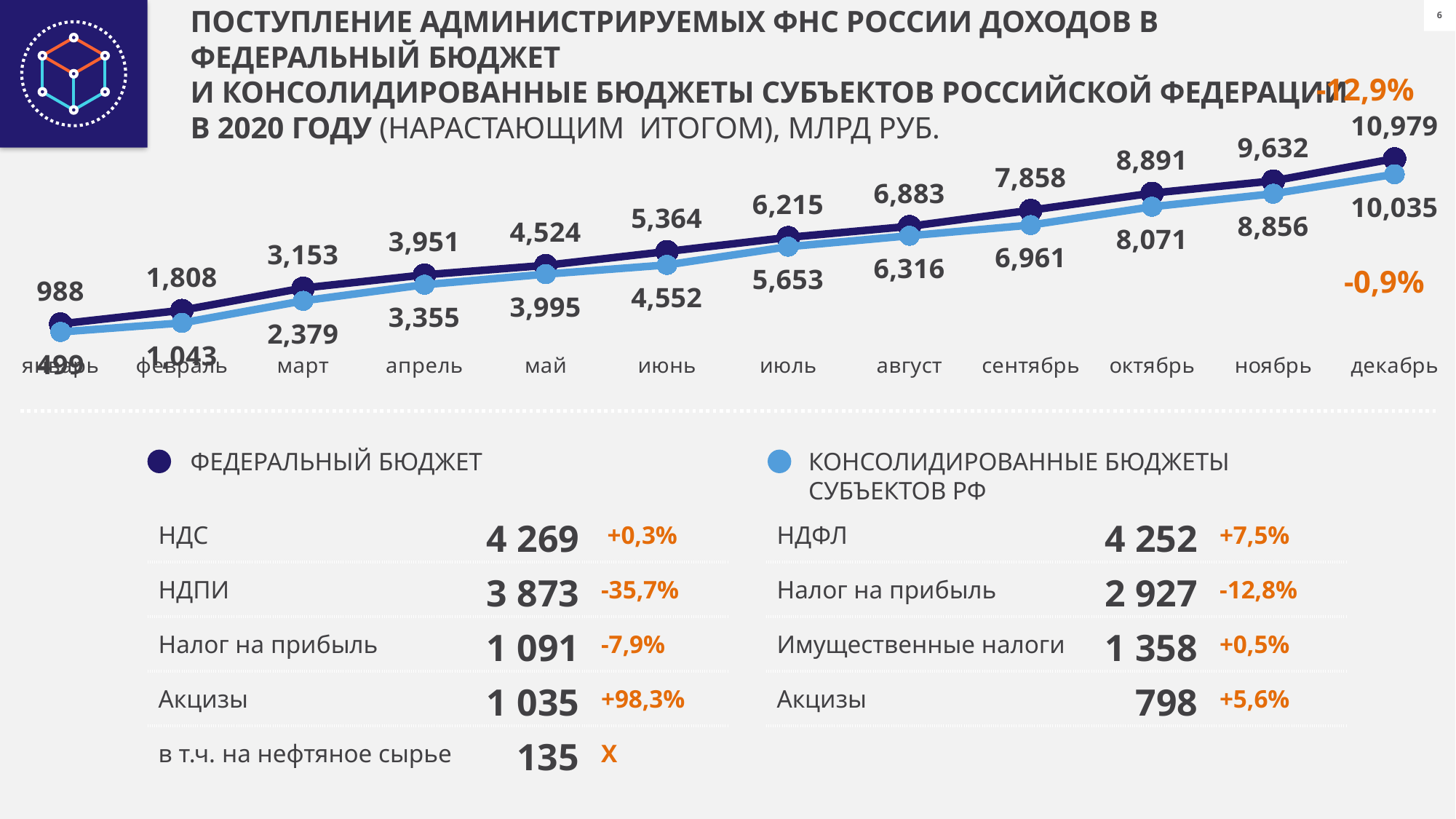
In which month is the federal budget series at its lowest? январь How many months are plotted on the x axis of the chart? 12 What is the value for the federal budget in March (март)? 3,153 What is the value for the consolidated budgets of the subjects of the RF (Консолидированные бюджеты субъектов РФ) in October (октябрь)? 8,071 What is the difference between the federal budget and the consolidated budgets values in December? 944 In which month is the consolidated budgets series at its highest? декабрь How many series does the chart's legend list? 2 What is the value for the federal budget (Федеральный бюджет) in December (декабрь)? 10,979 What type of chart is shown on the slide? line chart Do the values of the federal budget series rise or fall from January to December? rise Which series has the larger value in June (июнь): the federal budget or the consolidated budgets? Федеральный бюджет What is the difference between the federal budget and the consolidated budgets values in March? 774